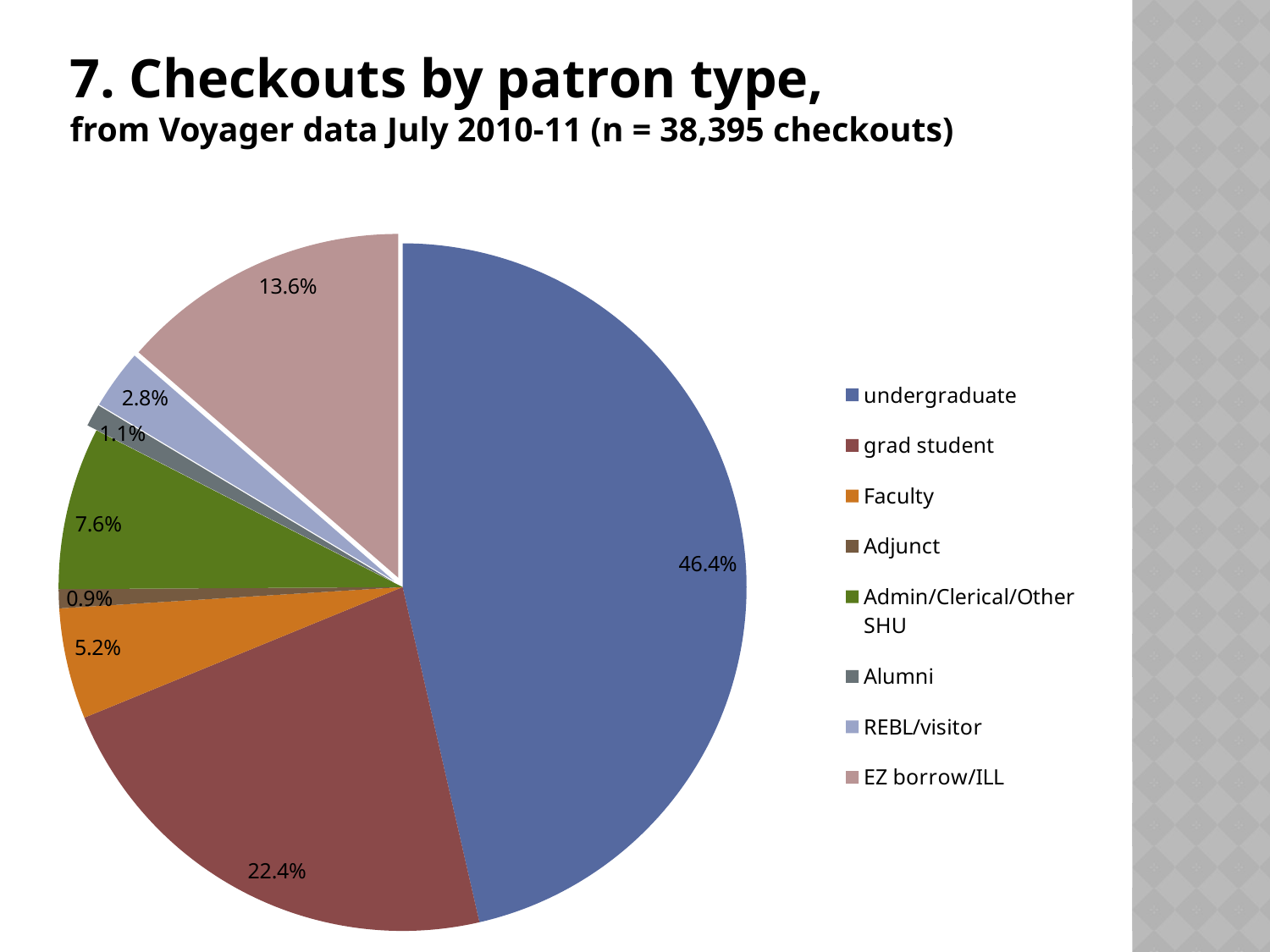
What percentage of checkouts does the grad student slice represent? 22.4% According to the slide subtitle, how many checkouts does the data cover? 38,395 What is the combined share of the Alumni and REBL/visitor slices? 3.9% Which patron type has the largest share of checkouts? undergraduate What kind of chart is shown on the slide? pie chart What is the value shown for the EZ borrow/ILL slice? 13.6% What share of checkouts is attributed to undergraduates in the pie chart? 46.4% Which slice is larger, Faculty or REBL/visitor? Faculty How many patron types are listed in the legend? 8 What percentage is shown for the Admin/Clerical/Other SHU slice? 7.6% What is the difference in percentage points between the undergraduate and grad student slices? 24.0% Which patron type has the smallest share of checkouts? Adjunct